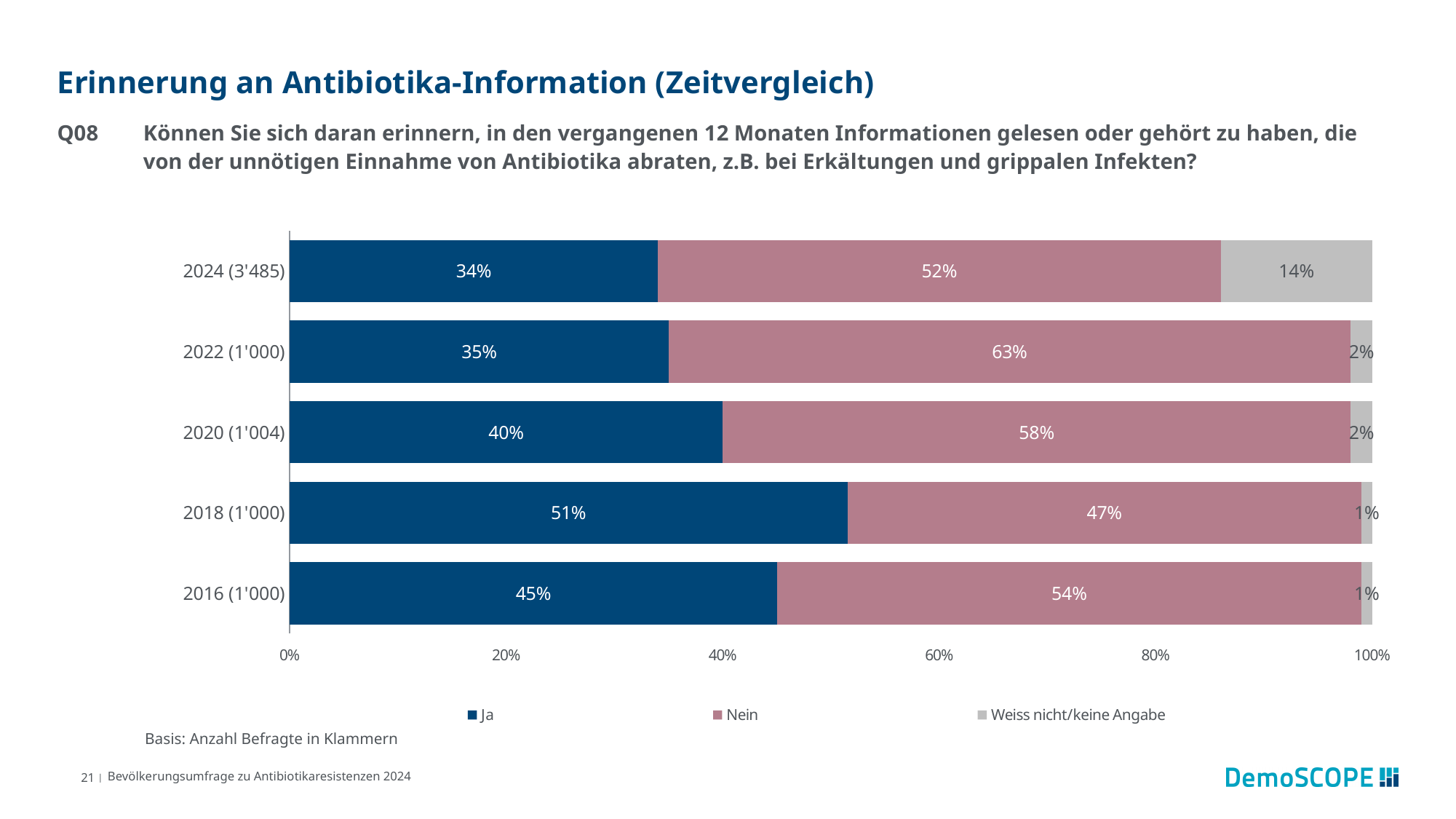
Which series is shown in dark blue in the legend? Ja Which year has the highest value for "Ja"? 2018 (1'000) How many years (categories) are shown in the chart? 5 What is the value for "Weiss nicht/keine Angabe" in 2024 (3'485)? 14% What is the value for "Ja" in 2024 (3'485)? 34% What is the difference between the "Nein" values for 2022 (1'000) and 2024 (3'485)? 11 percentage points How many series does the legend list? 3 Which is larger in 2016 (1'000): the "Ja" value or the "Nein" value? Nein What is the value for "Nein" in 2022 (1'000)? 63% Which year has the lowest value for "Ja"? 2024 (3'485) What kind of chart is shown on the slide? Stacked bar chart What is the total of the stacked bar for 2020 (1'004)? 100%